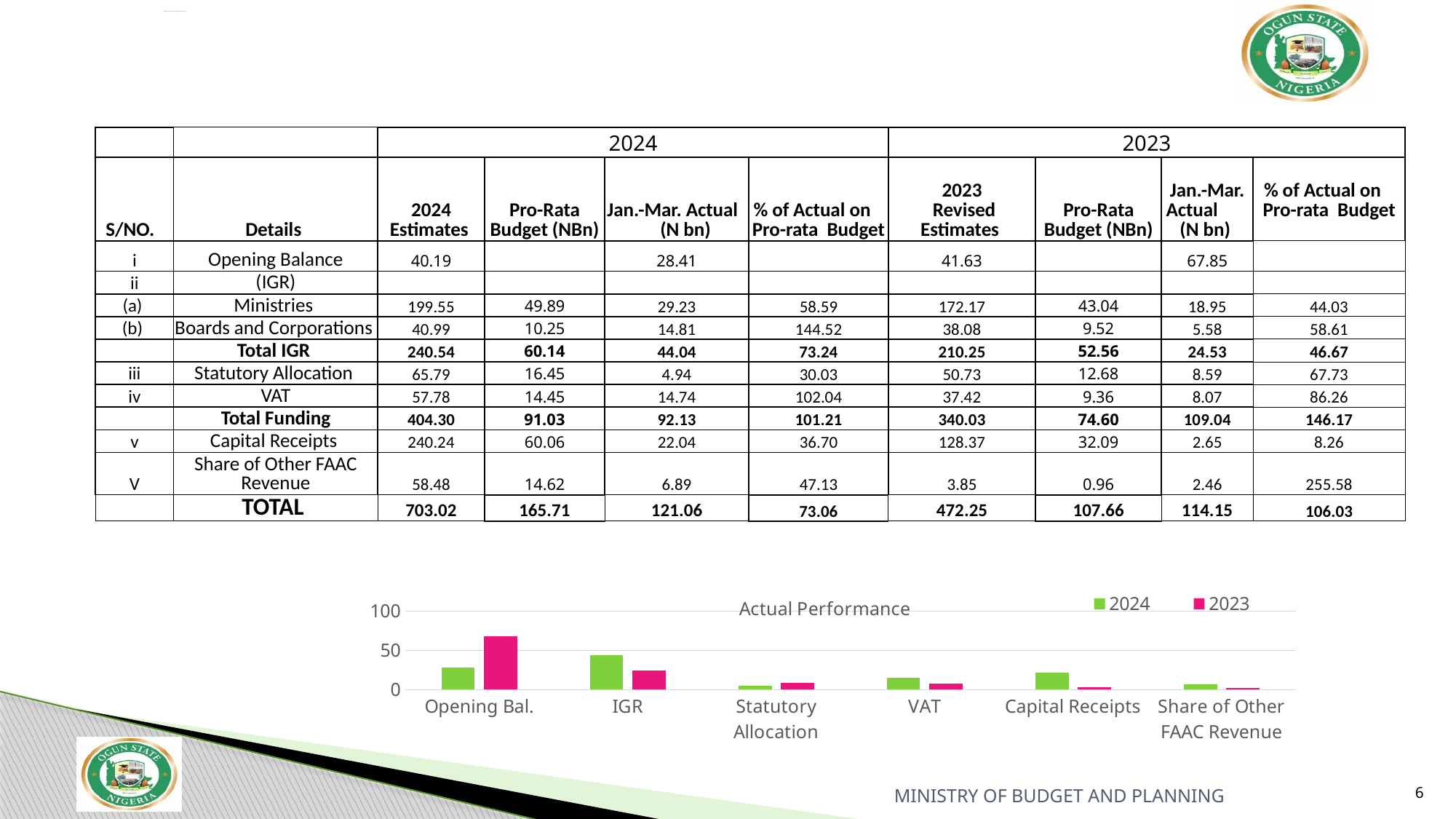
Is the 2023 value for Opening Bal. greater or less than 50? greater For Capital Receipts, which series has the larger value, 2024 or 2023? 2024 Is the 2024 value for IGR greater or less than 50? less For Opening Bal., which series has the larger value, 2024 or 2023? 2023 Which category has the highest 2024 value in the chart? IGR What is the title of the chart? Actual Performance Which category has the tallest bar in the chart? Opening Bal. How many series does the chart legend list? 2 What kind of chart is shown on the slide? bar chart For IGR, which series has the larger value, 2024 or 2023? 2024 Which colour represents the 2024 series in the chart? green How many categories are shown on the x axis of the chart? 6